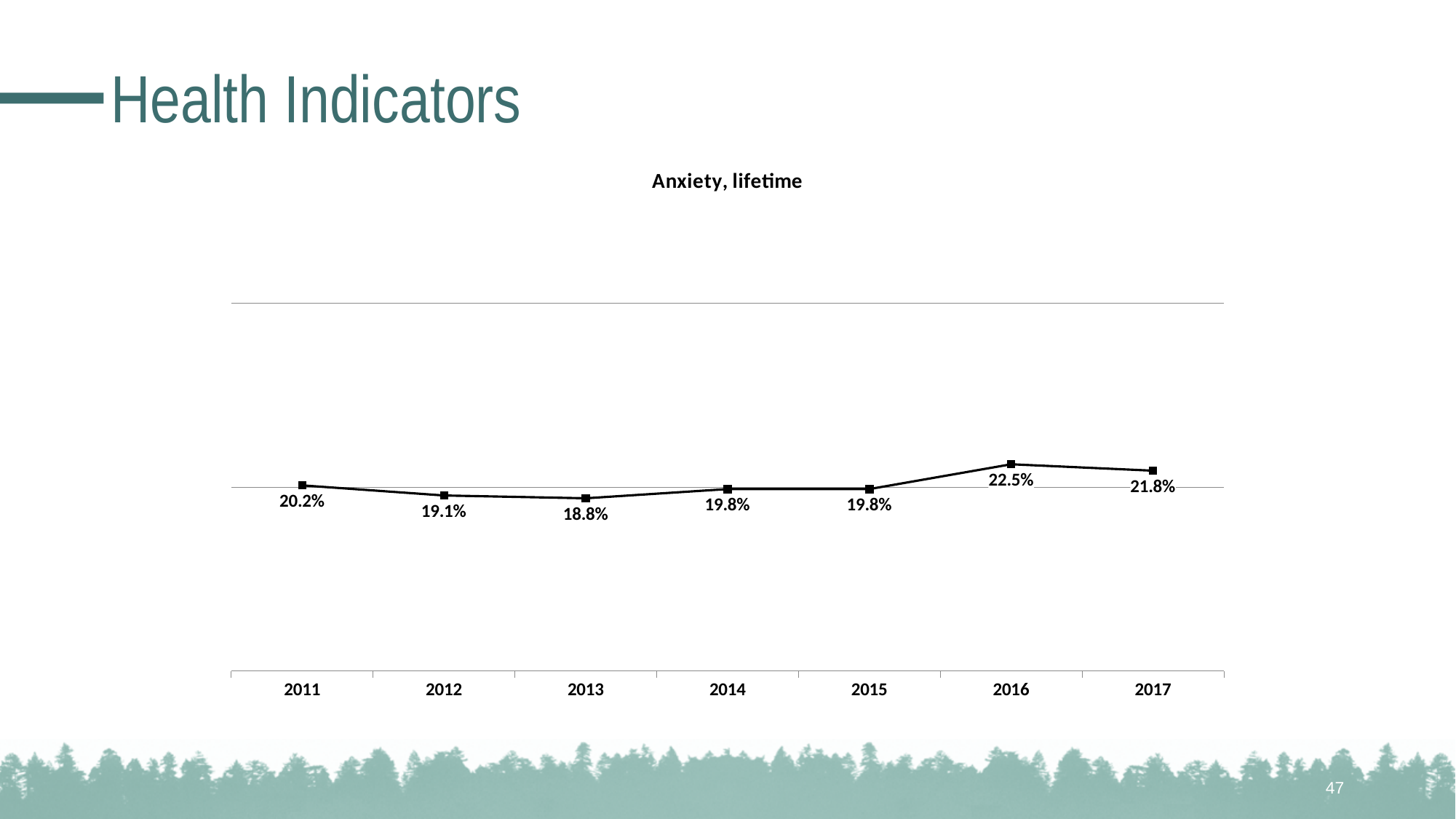
What is the value for 2016 in the Anxiety, lifetime chart? 22.5% What kind of chart is shown on the slide? Line chart What is the value for 2013 in the Anxiety, lifetime chart? 18.8% What is the difference between the 2016 and 2013 values in the Anxiety, lifetime chart? 3.7% What is the title of the chart on the slide? Anxiety, lifetime What is the value for 2017 in the Anxiety, lifetime chart? 21.8% Which year has the lowest value in the Anxiety, lifetime chart? 2013 How many years are plotted in the Anxiety, lifetime chart? 7 Which is larger in the Anxiety, lifetime chart, the value for 2012 or the value for 2017? 2017 What is the value for 2011 in the Anxiety, lifetime chart? 20.2% Which year has the highest value in the Anxiety, lifetime chart? 2016 What is the difference between the 2017 and 2011 values in the Anxiety, lifetime chart? 1.6%